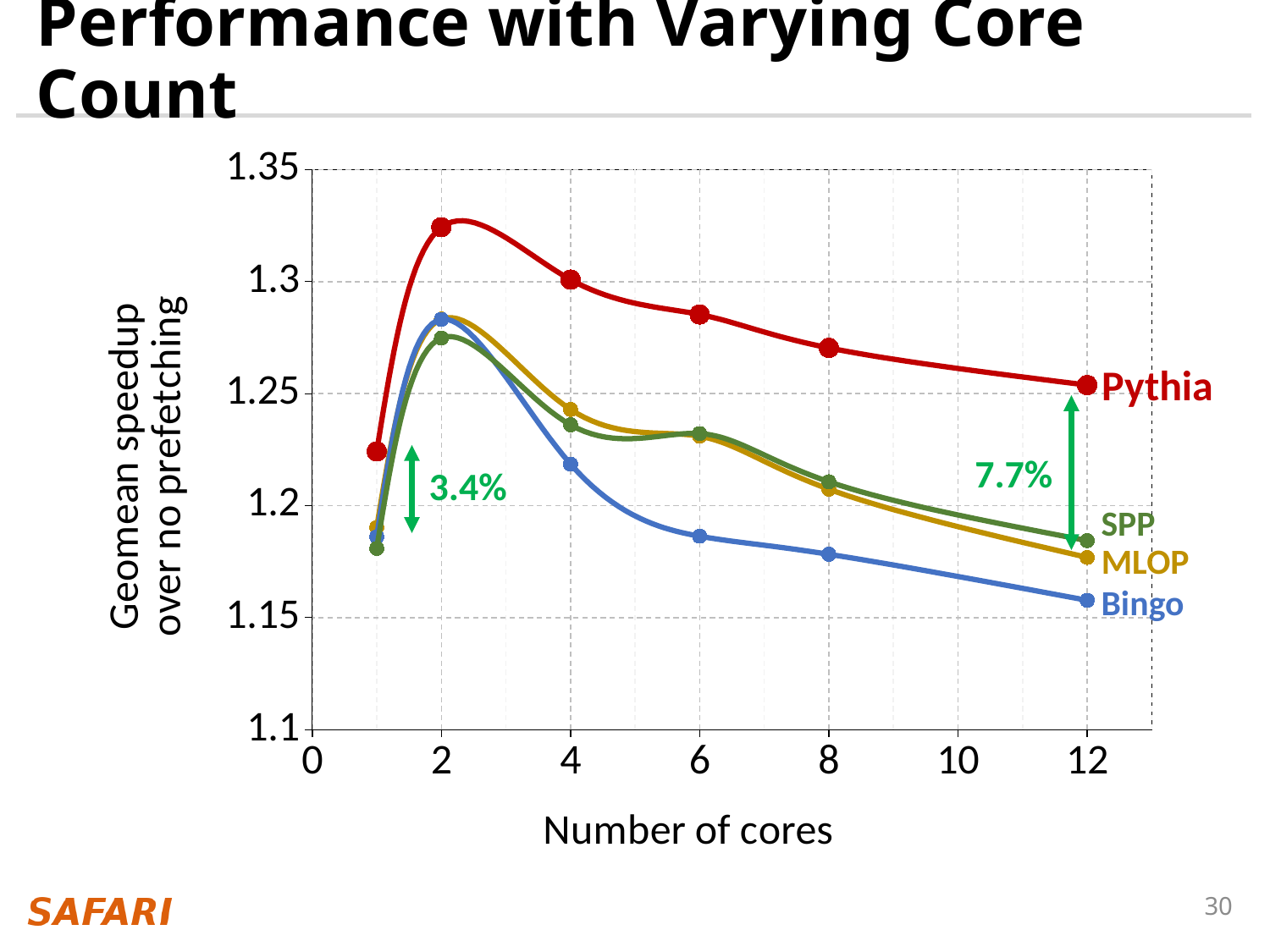
Which prefetcher has the lowest geomean speedup at 12 cores? Bingo At which number of cores does Pythia reach its highest geomean speedup? 2 At 6 cores, which has the larger geomean speedup, Pythia or Bingo? Pythia Is the geomean speedup for Pythia at 8 cores greater or less than 1.25? greater How many series (prefetchers) are plotted in the chart? 4 What kind of chart is shown on the slide? line chart Is the geomean speedup for Pythia at 2 cores greater or less than 1.3? greater What percentage gap is annotated between Pythia and SPP at 12 cores? 7.7% Which prefetcher has the highest geomean speedup at 12 cores? Pythia Does the geomean speedup for Pythia rise or fall as the number of cores increases from 2 to 12? fall Is the geomean speedup for Bingo at 12 cores greater or less than 1.2? less How many core-count data points are plotted for the Pythia series? 6